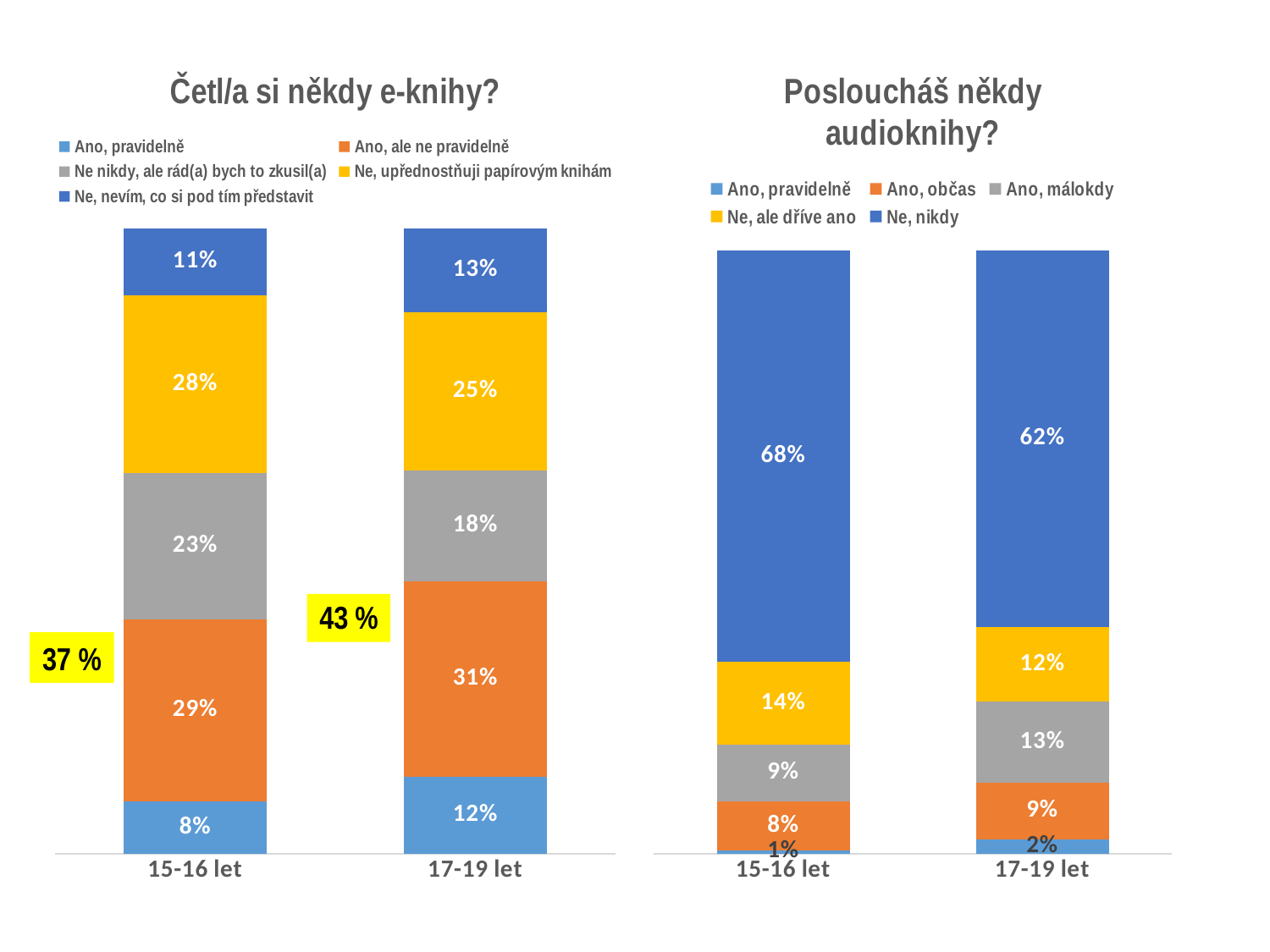
In the chart titled "Posloucháš někdy audioknihy?", what is the value for "Ano, málokdy" in the 17-19 let bar? 13% What kind of chart is the chart titled "Posloucháš někdy audioknihy?"? Stacked bar chart In the chart titled "Posloucháš někdy audioknihy?", which age group has the larger "Ne, nikdy" value? 15-16 let In the chart titled "Četl/a si někdy e-knihy?", what is the value for "Ano, pravidelně" in the 15-16 let bar? 8% In the chart titled "Posloucháš někdy audioknihy?", what is the total of the 15-16 let stacked bar? 100% In the chart titled "Četl/a si někdy e-knihy?", what is the difference between the "Ano, ale ne pravidelně" values for 17-19 let and 15-16 let? 2% How many age-group categories are shown on the x axis of the chart titled "Posloucháš někdy audioknihy?"? 2 In the chart titled "Posloucháš někdy audioknihy?", which series has the smallest segment in the 15-16 let bar? Ano, pravidelně In the chart titled "Četl/a si někdy e-knihy?", which series has the largest segment in the 17-19 let bar? Ano, ale ne pravidelně In the chart titled "Četl/a si někdy e-knihy?", what is the value for "Ne, upřednostňuji papírovým knihám" in the 17-19 let bar? 25% In the chart titled "Posloucháš někdy audioknihy?", what is the value for "Ne, nikdy" in the 15-16 let bar? 68% How many series does the legend of the chart titled "Četl/a si někdy e-knihy?" list? 5